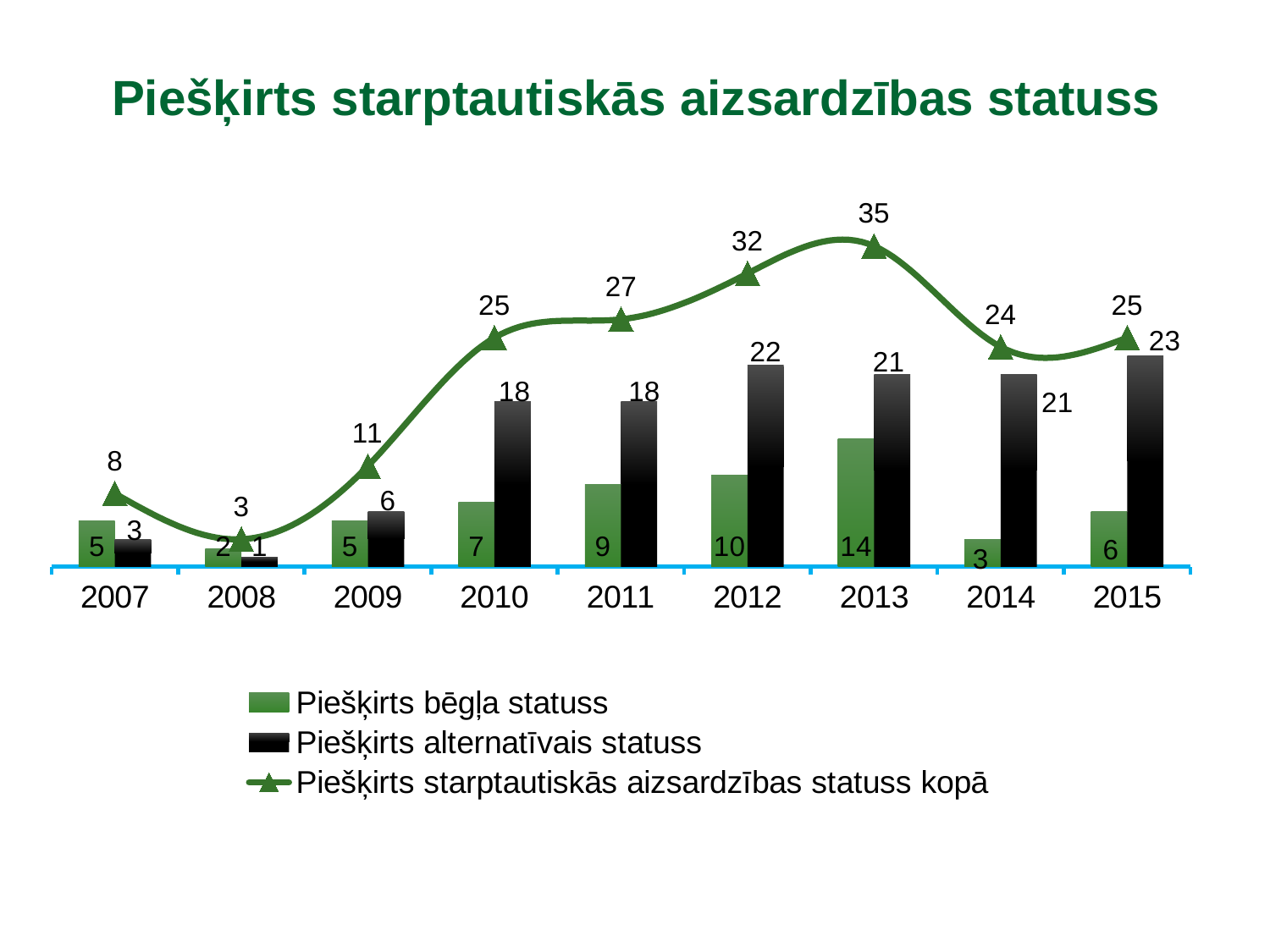
How many series does the legend list? 3 Does Piešķirts starptautiskās aizsardzības statuss kopā rise or fall from 2013 to 2014? Fall In which year is Piešķirts starptautiskās aizsardzības statuss kopā highest? 2013 What is the value of Piešķirts bēgļa statuss in 2013? 14 What is the title of the chart? Piešķirts starptautiskās aizsardzības statuss What is the value of Piešķirts starptautiskās aizsardzības statuss kopā in 2010? 25 How many years are shown on the x axis? 9 What is the value of Piešķirts alternatīvais statuss in 2012? 22 Which is larger in 2009: Piešķirts bēgļa statuss or Piešķirts alternatīvais statuss? Piešķirts alternatīvais statuss In which year is Piešķirts alternatīvais statuss lowest? 2008 What kind of chart is this? Combined bar and line chart What is the difference between Piešķirts alternatīvais statuss and Piešķirts bēgļa statuss in 2015? 17